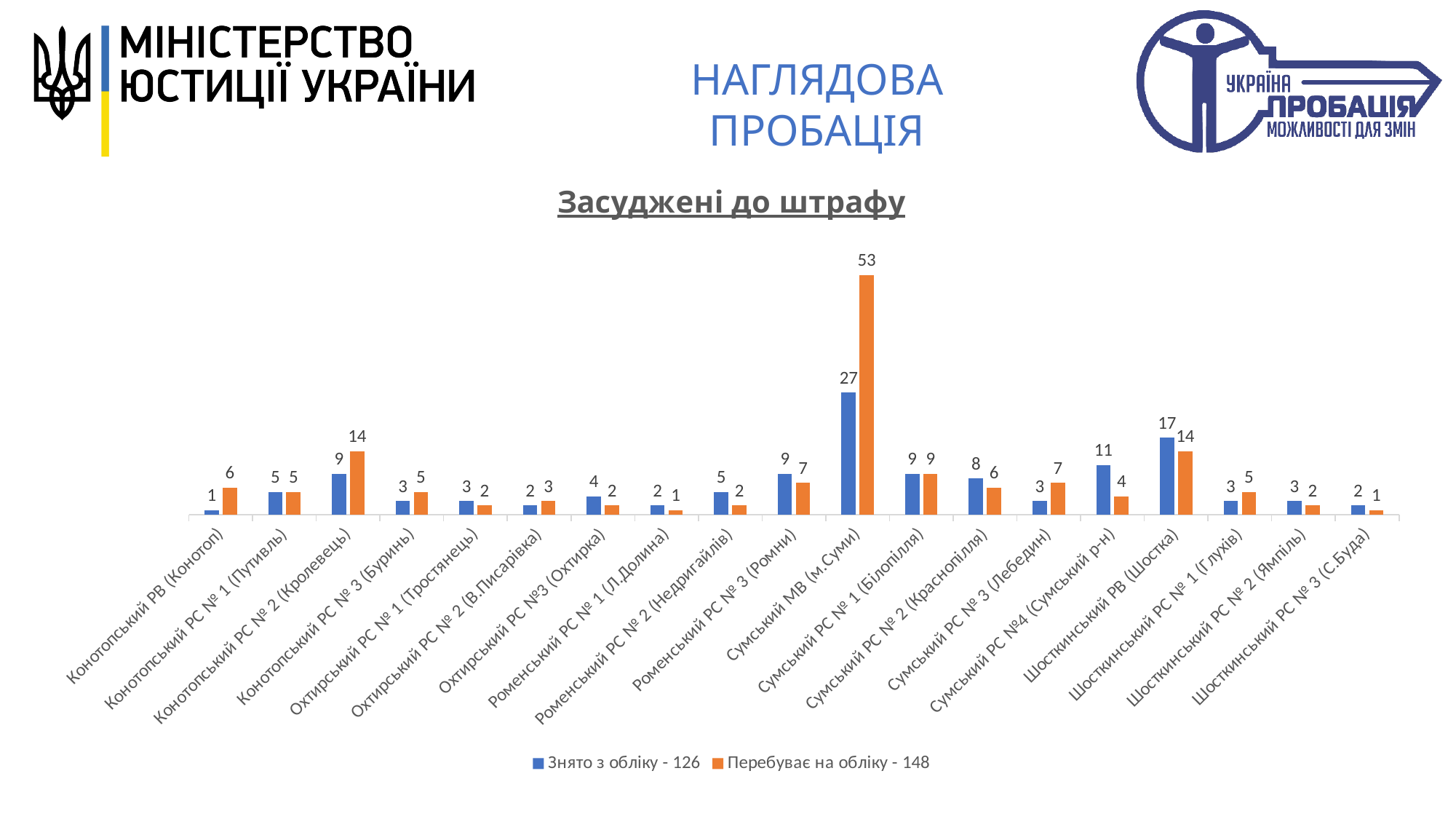
What is the value of 'Перебуває на обліку' for Конотопський РС № 2 (Кролевець)? 14 What is the value of 'Знято з обліку' for Сумський МВ (м.Суми)? 27 What is the value of 'Знято з обліку' for Шосткинський РВ (Шостка)? 17 What kind of chart is shown on the slide? Bar chart How many series does the legend list? 2 Which category has the highest value for 'Перебуває на обліку'? Сумський МВ (м.Суми) What is the difference between 'Перебуває на обліку' and 'Знято з обліку' for Сумський МВ (м.Суми)? 26 What is the title of the chart? Засуджені до штрафу For Сумський РС №4 (Сумський р-н), which is larger: 'Знято з обліку' or 'Перебуває на обліку'? Знято з обліку Which category has the lowest value for 'Знято з обліку'? Конотопський РВ (Конотоп) How many categories are shown on the x axis? 19 What is the total of the two values for Роменський РС № 3 (Ромни)? 16